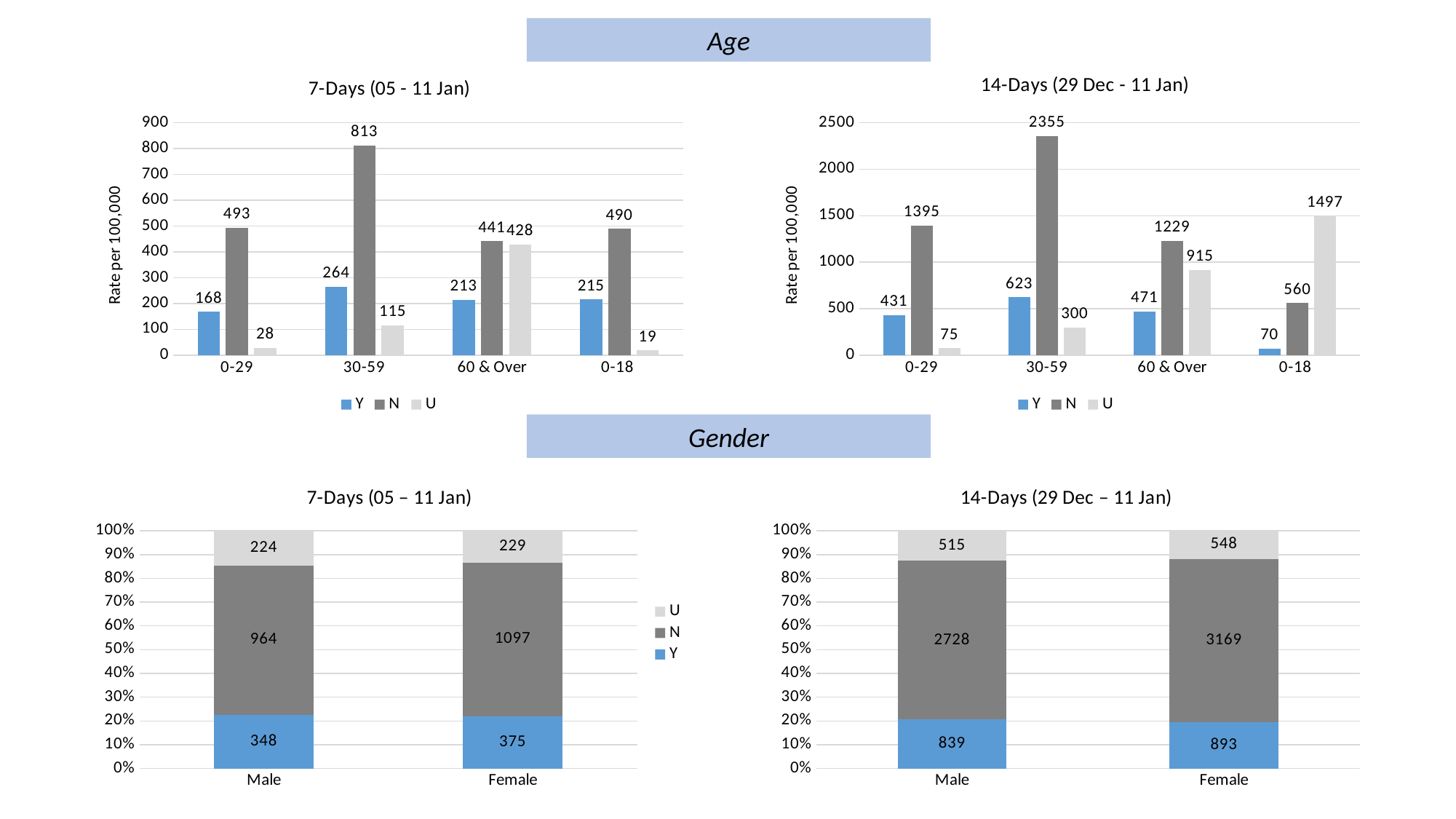
In the Age 7-Days (05 - 11 Jan) chart, what is the difference between the N values for 0-29 and 0-18? 3 How many series does the legend list in the Age 7-Days (05 - 11 Jan) chart? 3 In the Gender 14-Days (29 Dec – 11 Jan) chart, what is the difference between the Y values for Female and Male? 54 In the Age 7-Days (05 - 11 Jan) chart, what is the N value for the 30-59 age group? 813 In the Gender 7-Days (05 – 11 Jan) chart, what is the total of the Male bar? 1536 In the Gender 14-Days (29 Dec – 11 Jan) chart, what is the N value for Female? 3169 How many age groups are shown on the x axis of the Age 14-Days (29 Dec - 11 Jan) chart? 4 In the Age 14-Days (29 Dec - 11 Jan) chart, what is the U value for the 0-18 age group? 1497 In the Age 14-Days (29 Dec - 11 Jan) chart, which age group has the lowest Y value? 0-18 In the Age 7-Days (05 - 11 Jan) chart, which age group has the highest Y value? 30-59 In the Age 14-Days (29 Dec - 11 Jan) chart, which is larger: the N value for 60 & Over or the U value for 60 & Over? N value for 60 & Over What kind of chart is the Gender 7-Days (05 – 11 Jan) chart? Stacked bar chart